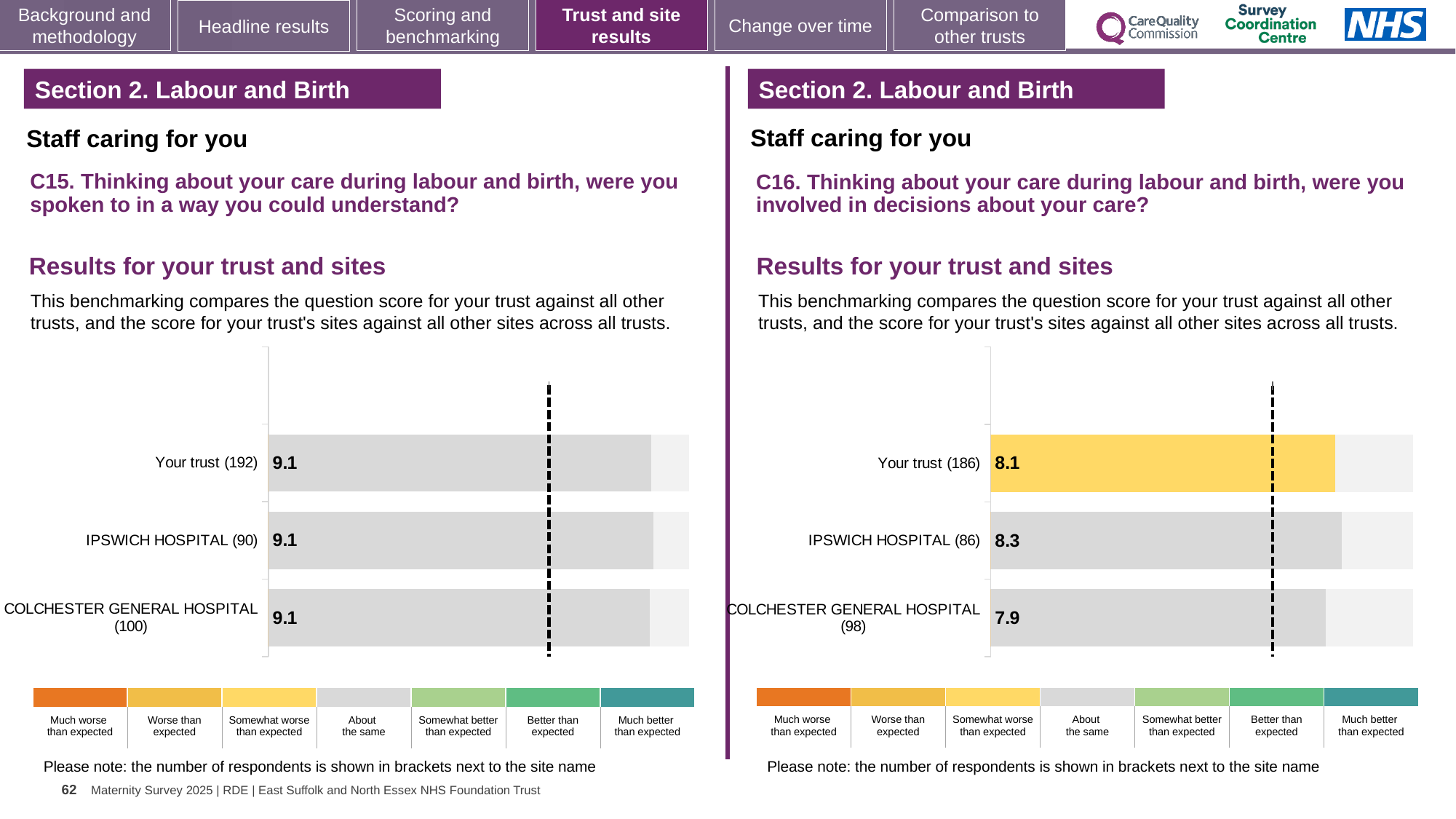
In the C15 chart on the left, what is the score for IPSWICH HOSPITAL? 9.1 What type of chart is used in the C16 chart on the right? Bar chart In the C16 chart on the right, which site or trust has the highest score? IPSWICH HOSPITAL In the C15 chart on the left, what is the difference between the scores for Your trust and COLCHESTER GENERAL HOSPITAL? 0 In the C16 chart on the right, which site or trust has the lowest score? COLCHESTER GENERAL HOSPITAL In the C16 chart on the right, what is the score for COLCHESTER GENERAL HOSPITAL? 7.9 In the C15 chart on the left, what is the score for Your trust? 9.1 In the C16 chart on the right, how many respondents are shown in brackets for Your trust? 186 In the C16 chart on the right, what is the difference between the scores for IPSWICH HOSPITAL and COLCHESTER GENERAL HOSPITAL? 0.4 In the C16 chart on the right, which has the larger score, Your trust or IPSWICH HOSPITAL? IPSWICH HOSPITAL In the C15 chart on the left, how many bars are plotted? 3 In the C16 chart on the right, what is the score for Your trust? 8.1